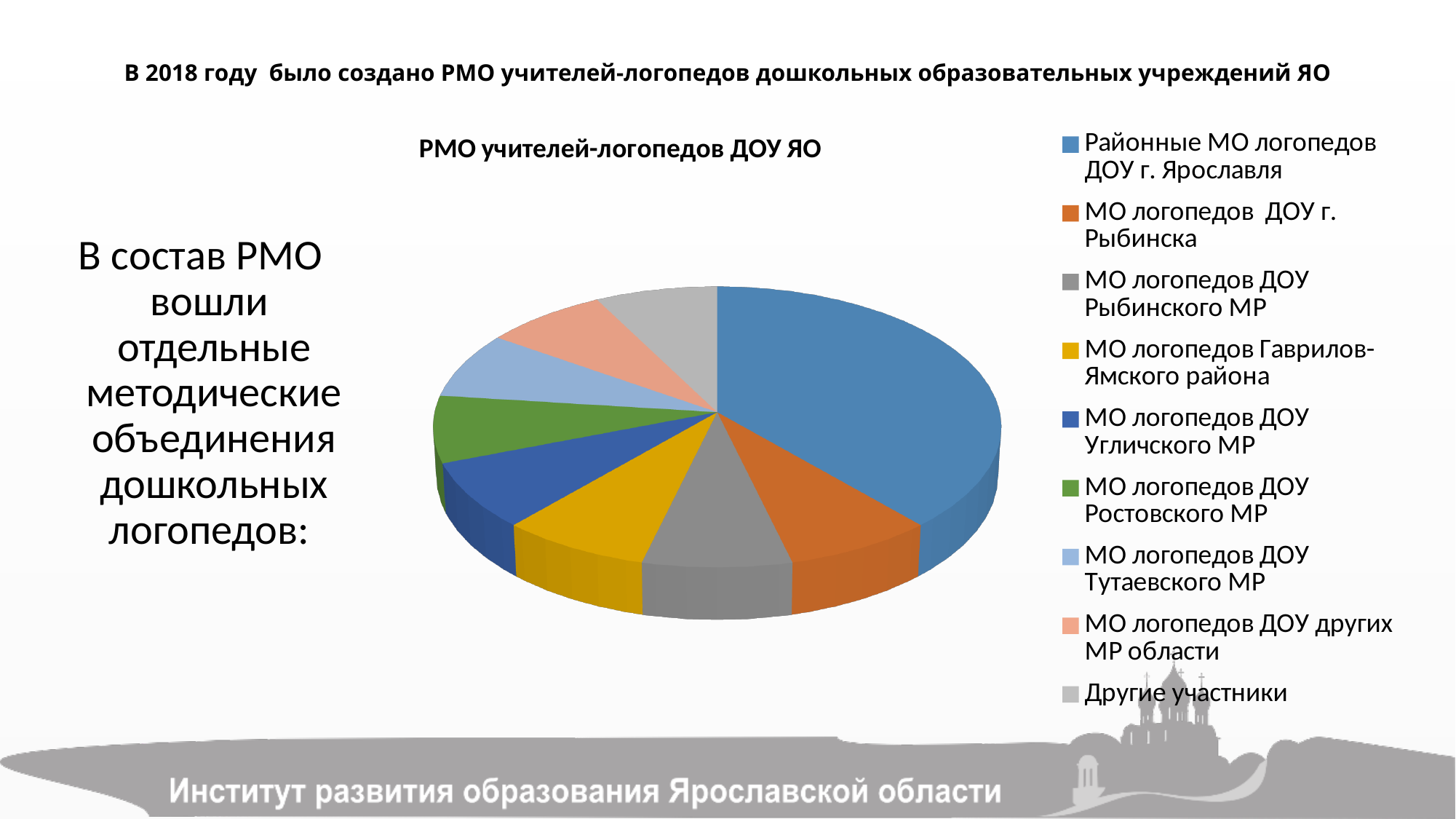
What is the title of the chart? РМО учителей-логопедов ДОУ ЯО What kind of chart is shown on the slide? pie chart How many categories does the pie chart have? 9 Which category has the largest slice of the pie? Районные МО логопедов ДОУ г. Ярославля What colour is the slice for МО логопедов ДОУ Ростовского МР? green Which slice is larger: Районные МО логопедов ДОУ г. Ярославля or МО логопедов ДОУ г. Рыбинска? Районные МО логопедов ДОУ г. Ярославля Which slice is larger: Районные МО логопедов ДОУ г. Ярославля or Другие участники? Районные МО логопедов ДОУ г. Ярославля